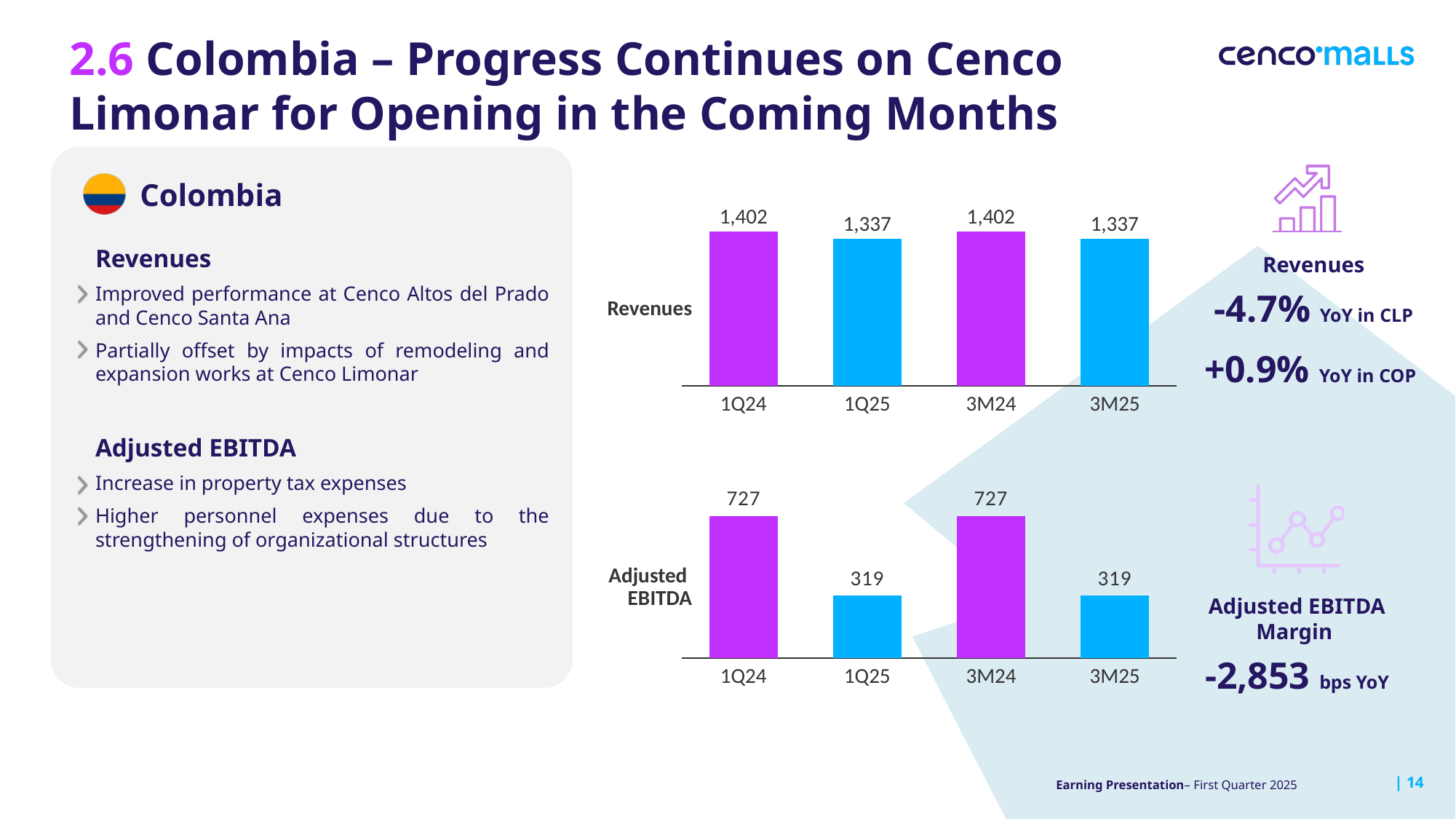
In the Adjusted EBITDA chart, what is the value for 1Q25? 319 In the Adjusted EBITDA chart, what is the value for 3M24? 727 How many bars are shown in the Revenues chart? 4 In the Revenues chart, what is the value for 1Q25? 1,337 What are the period labels on the x axis of the Revenues chart? 1Q24, 1Q25, 3M24, 3M25 In the Revenues chart, what is the difference between the 1Q24 and 1Q25 values? 65 In the Adjusted EBITDA chart, which period has the highest value? 1Q24 and 3M24 (727) In the Adjusted EBITDA chart, which is larger, the value for 3M24 or 3M25? 3M24 In the Revenues chart, which period has the lowest value? 1Q25 and 3M25 (1,337) In the Revenues chart, what is the value for 1Q24? 1,402 In the Adjusted EBITDA chart, what is the difference between the 1Q24 and 1Q25 values? 408 What type of chart is used to show Adjusted EBITDA? Bar chart